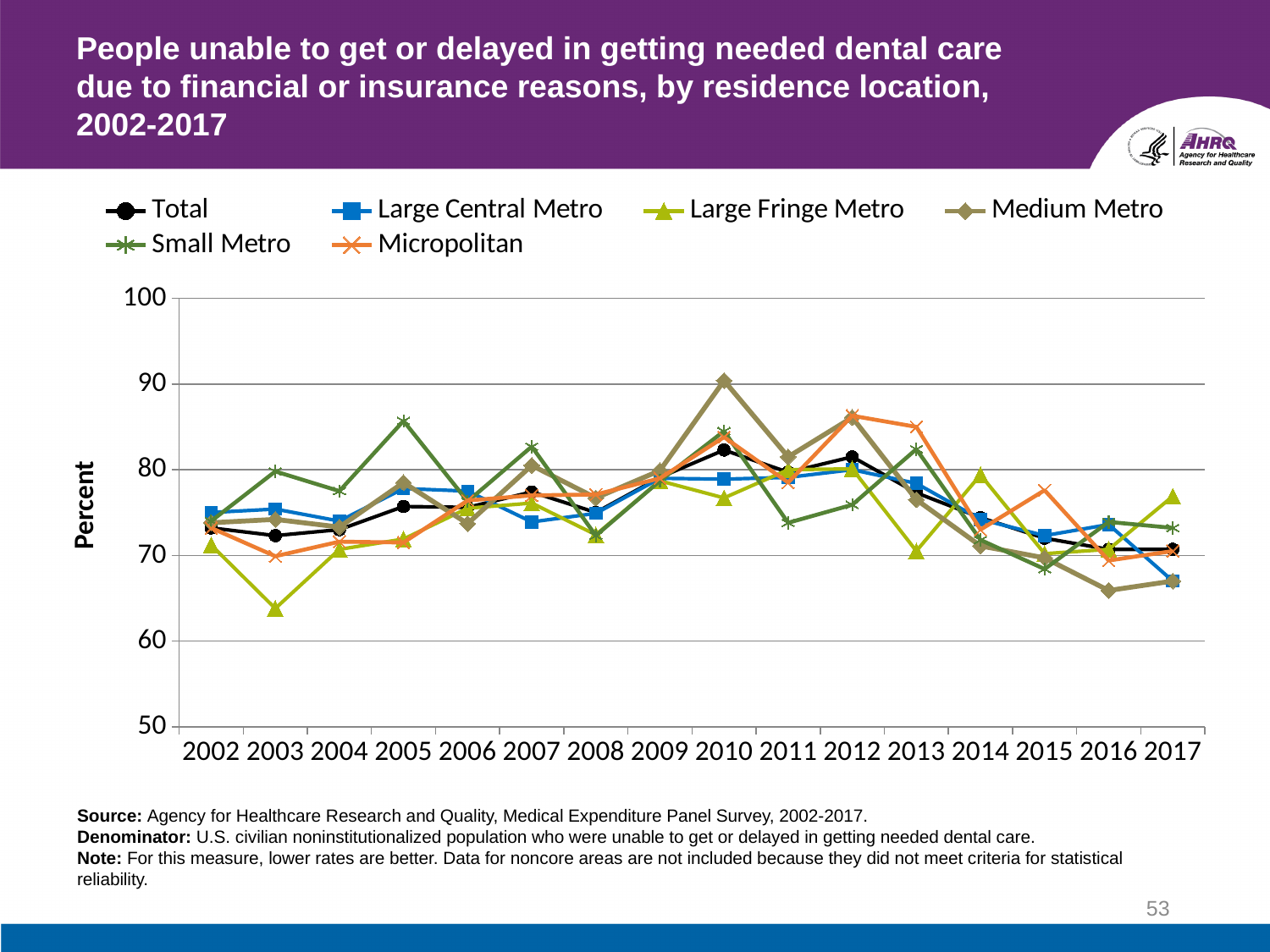
Is the value for Medium Metro in 2010 greater or less than 80? greater Does the Total series rise or fall from 2012 to 2017? Fall How many years are plotted along the x axis? 16 What kind of chart is shown on the slide? Line chart What is the label on the y axis? Percent In 2010, which is larger: the value for Medium Metro or the value for Large Fringe Metro? Medium Metro Is the value for Medium Metro in 2016 greater or less than 70? less Is the value for Large Fringe Metro in 2003 greater or less than 70? less How many series does the legend list? 6 Which series has the lowest value in 2003? Large Fringe Metro Which series has the highest value in 2005? Small Metro Which series has the highest value in 2010? Medium Metro